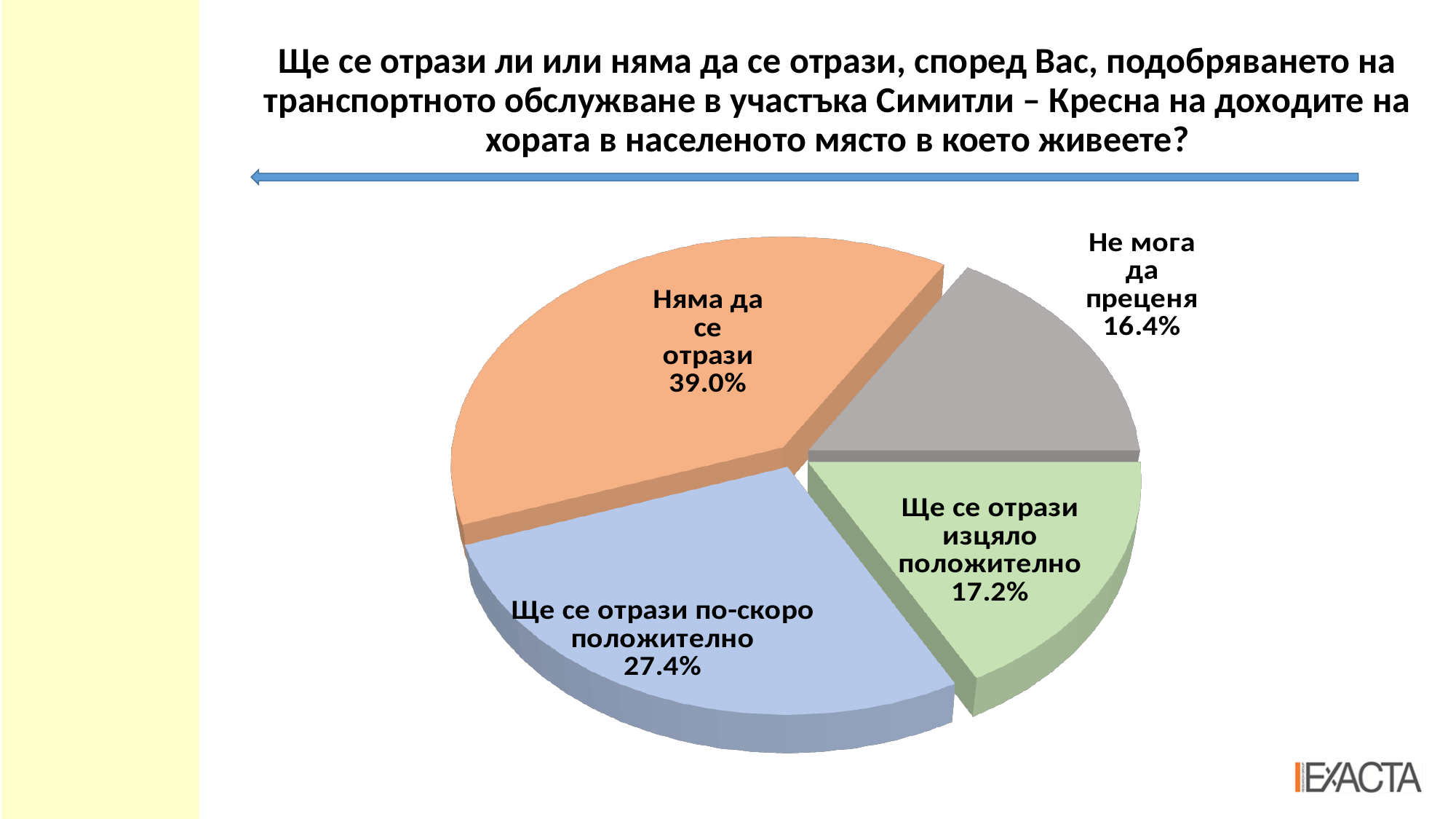
What share of the pie does the slice "Няма да се отрази" represent? 39.0% Which slice of the pie is the smallest? Не мога да преценя What is the difference between the "Ще се отрази изцяло положително" slice and the "Не мога да преценя" slice? 0.8% How many slices does the pie chart have? 4 Which is larger: "Ще се отрази по-скоро положително" or "Ще се отрази изцяло положително"? Ще се отрази по-скоро положително What is the value shown for "Не мога да преценя"? 16.4% What kind of chart is shown on the slide? Pie chart What is the difference between the "Няма да се отрази" slice and the "Ще се отрази по-скоро положително" slice? 11.6% Which slice of the pie is the largest? Няма да се отрази What is the value shown for "Ще се отрази по-скоро положително"? 27.4% What is the value shown for "Ще се отрази изцяло положително"? 17.2% What colour is the slice for "Ще се отрази изцяло положително"? Green